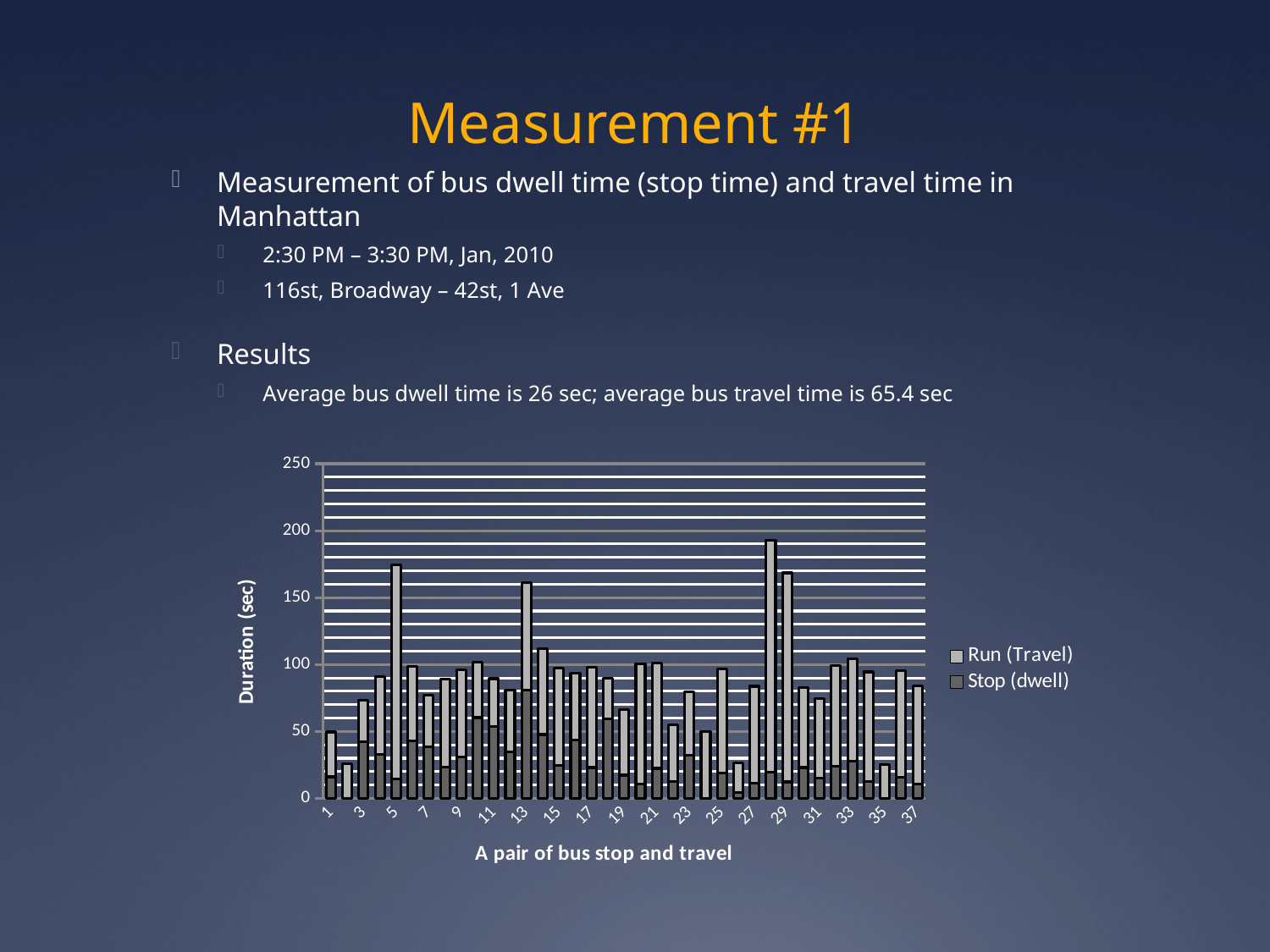
What kind of chart is shown on the slide? Stacked bar chart Which pair has the tallest stacked bar in the chart? 28 Which has the larger total duration, pair 5 or pair 13? Pair 5 Is the total duration for pair 2 greater or less than 50? less Which has the larger total duration, pair 28 or pair 29? Pair 28 What is the title of the chart's vertical axis? Duration (sec) What are the two series named in the chart legend? Run (Travel) and Stop (dwell) How many series does the chart legend list? 2 Is the total duration for pair 5 greater or less than 150? greater How many bus stop-and-travel pairs are plotted along the x axis? 37 Is the total duration for pair 28 greater or less than 150? greater